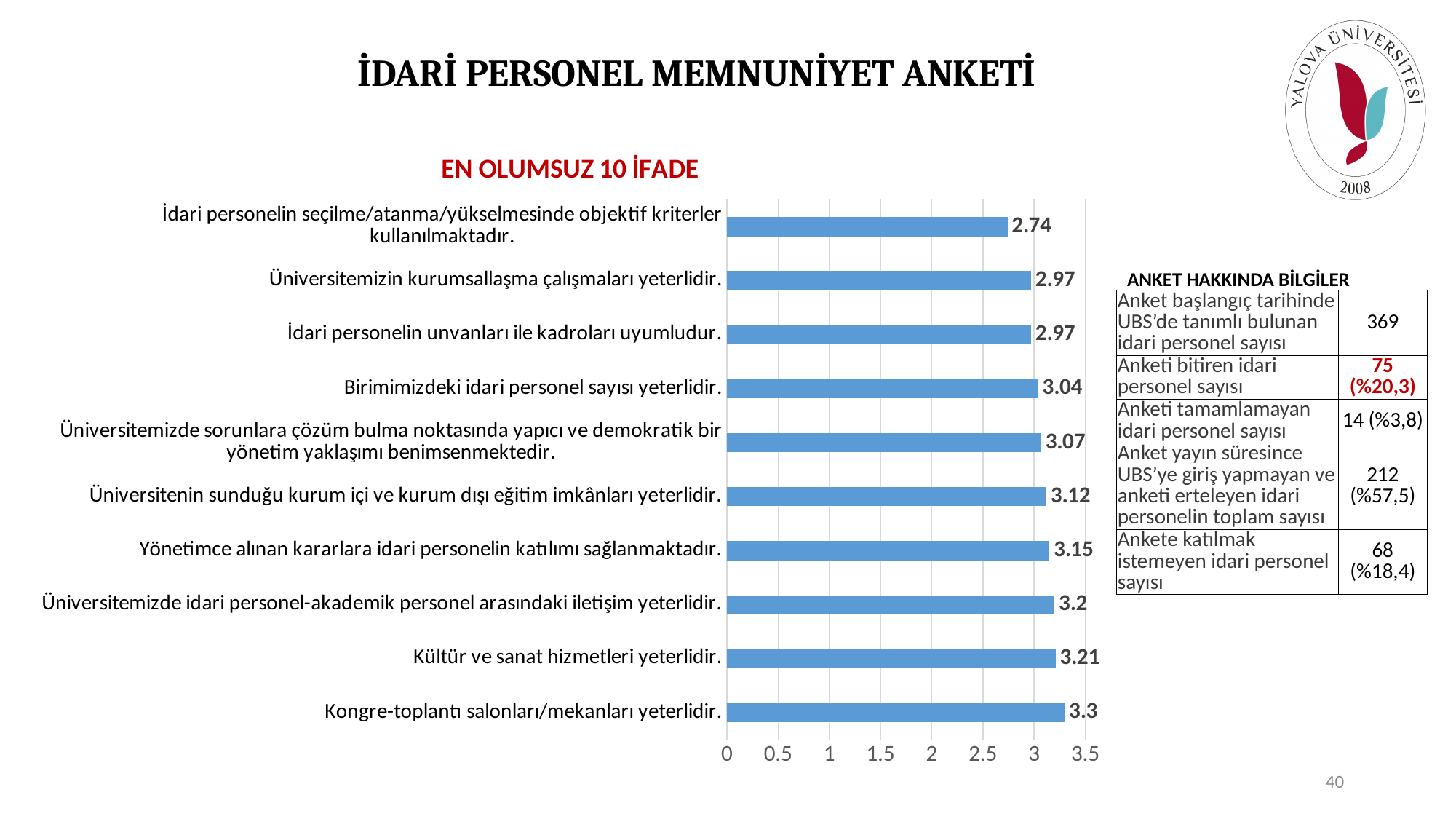
What kind of chart is shown on the slide? bar chart How many statements (bars) are shown in the chart? 10 Which statement has the lowest value in the chart? İdari personelin seçilme/atanma/yükselmesinde objektif kriterler kullanılmaktadır. What is the value for "Birimimizdeki idari personel sayısı yeterlidir."? 3.04 Which statement has the highest value in the chart? Kongre-toplantı salonları/mekanları yeterlidir. What is the difference between the values for "Yönetimce alınan kararlara idari personelin katılımı sağlanmaktadır." and "Birimimizdeki idari personel sayısı yeterlidir."? 0.11 What is the value for "Kongre-toplantı salonları/mekanları yeterlidir."? 3.3 Which is larger: the value for "Kültür ve sanat hizmetleri yeterlidir." or the value for "Birimimizdeki idari personel sayısı yeterlidir."? Kültür ve sanat hizmetleri yeterlidir. Is the value for "İdari personelin seçilme/atanma/yükselmesinde objektif kriterler kullanılmaktadır." greater or less than 3? less What is the title of the chart? EN OLUMSUZ 10 İFADE What is the value for "Yönetimce alınan kararlara idari personelin katılımı sağlanmaktadır."? 3.15 What is the difference between the highest value (3.3) and the lowest value (2.74) in the chart? 0.56